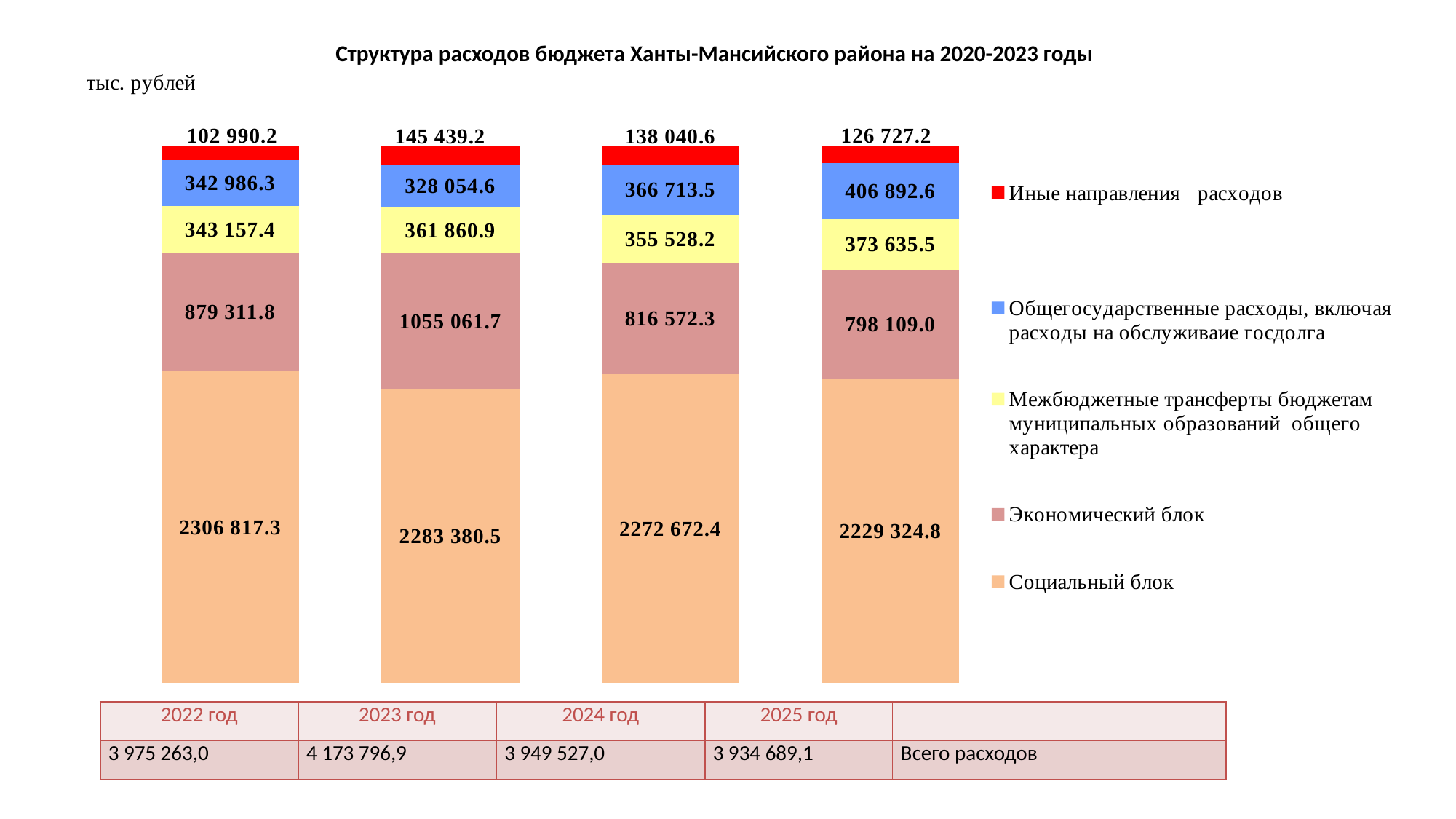
How many series does the legend list? 5 What is the value of Социальный блок for 2022 год? 2306 817.3 What is the value of Экономический блок for 2023 год? 1055 061.7 In which year is the Социальный блок segment the lowest? 2025 год In which year is the Иные направления расходов segment the highest? 2023 год What is the total of the stacked bar for 2023 год (Всего расходов)? 4 173 796,9 Does the Социальный блок value rise or fall from 2022 год to 2025 год? fall Which is larger: Общегосударственные расходы in 2025 год or in 2022 год? 2025 год What is the value of Общегосударственные расходы, включая расходы на обслуживаие госдолга for 2025 год? 406 892.6 What is the difference between Экономический блок in 2023 год and in 2022 год? 175 749.9 What is the value of Иные направления расходов for 2024 год? 138 040.6 How many stacked bars (years) are shown in the chart? 4